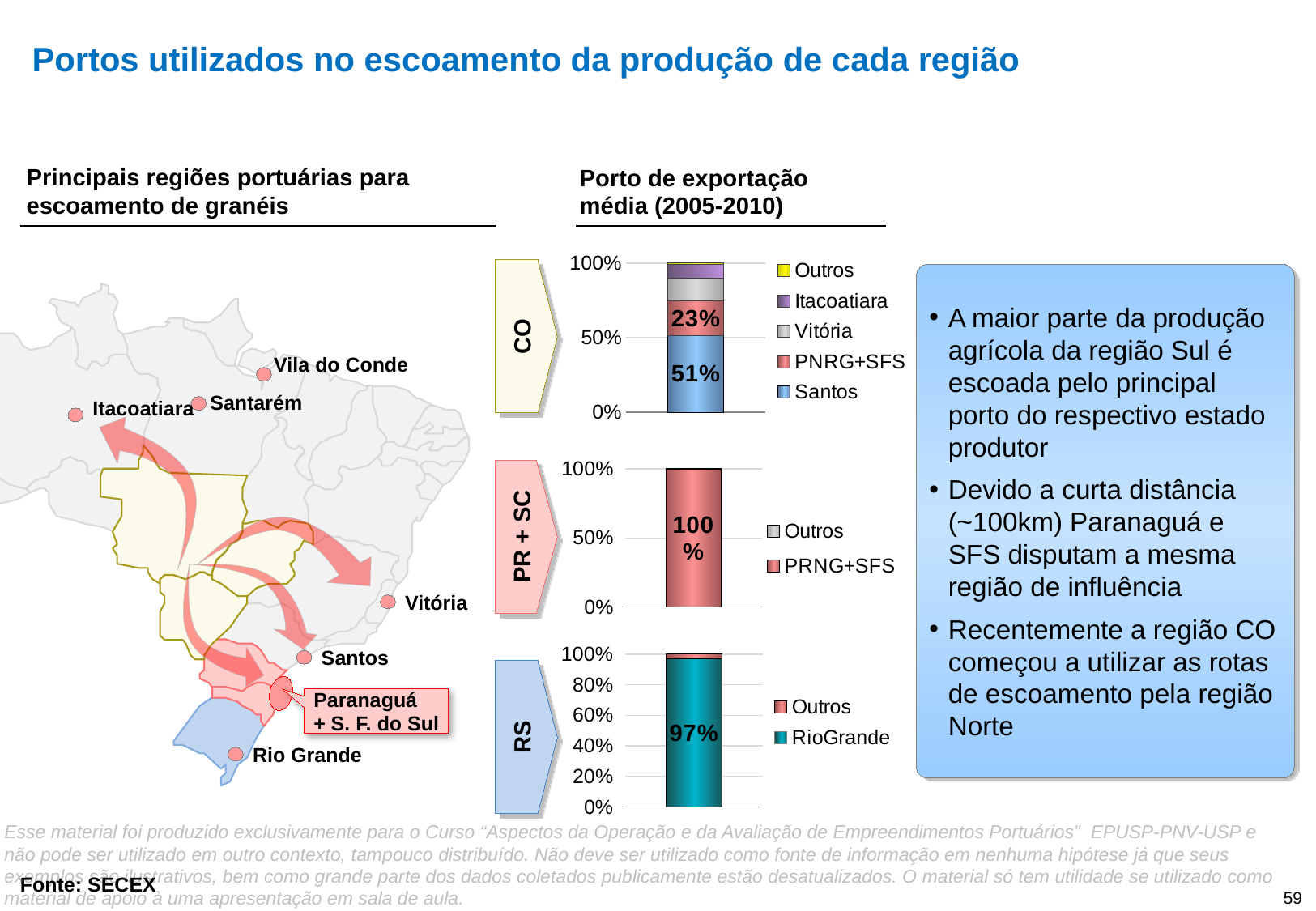
In the RS chart, what share is shown for RioGrande? 97% In the CO chart, what share is shown for Santos? 51% In the CO chart, what is the difference between the Santos share and the PNRG+SFS share? 28 percentage points In the CO chart, how many series does the legend list? 5 In the PR + SC chart, what share is shown for PRNG+SFS? 100% In the PR + SC chart, how many series does the legend list? 2 In the CO chart, which is larger, the share for Santos or the share for PNRG+SFS? Santos What is the title above the three bar charts? Porto de exportação média (2005-2010) In the CO chart, what share is shown for PNRG+SFS? 23% What kind of chart is used for the CO, PR + SC and RS regions? Stacked bar chart In the CO chart, which port has the largest share? Santos In the RS chart, is the value for RioGrande greater or less than 80%? greater